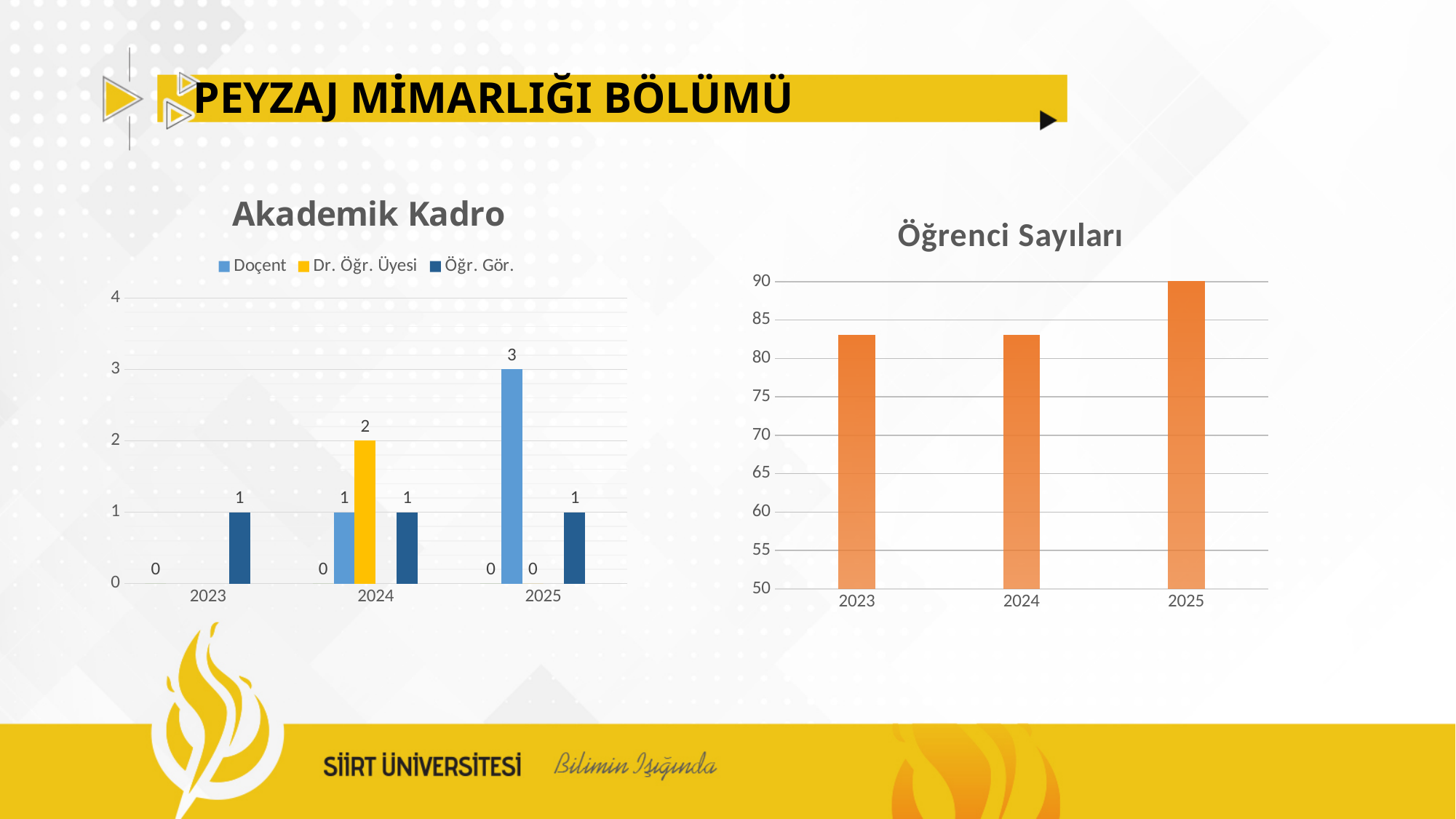
In the Akademik Kadro chart, what is the difference between the Doçent value in 2025 and the Doçent value in 2024? 2 In the Akademik Kadro chart, which year has the highest Doçent value? 2025 What kind of chart is the Öğrenci Sayıları chart? bar chart In the Öğrenci Sayıları chart, how many years are shown on the x axis? 3 In the Öğrenci Sayıları chart, is the value for 2023 greater or less than 80? greater In the Akademik Kadro chart, what is the value for Dr. Öğr. Üyesi in 2024? 2 In the Akademik Kadro chart, which is larger in 2024: Dr. Öğr. Üyesi or Öğr. Gör.? Dr. Öğr. Üyesi In the Akademik Kadro chart, what is the value for Öğr. Gör. in 2023? 1 In the Akademik Kadro chart, what is the value for Doçent in 2024? 1 In the Akademik Kadro chart, what is the value for Doçent in 2025? 3 In the Akademik Kadro chart, how many series does the legend list? 3 In the Öğrenci Sayıları chart, which year has the highest value? 2025